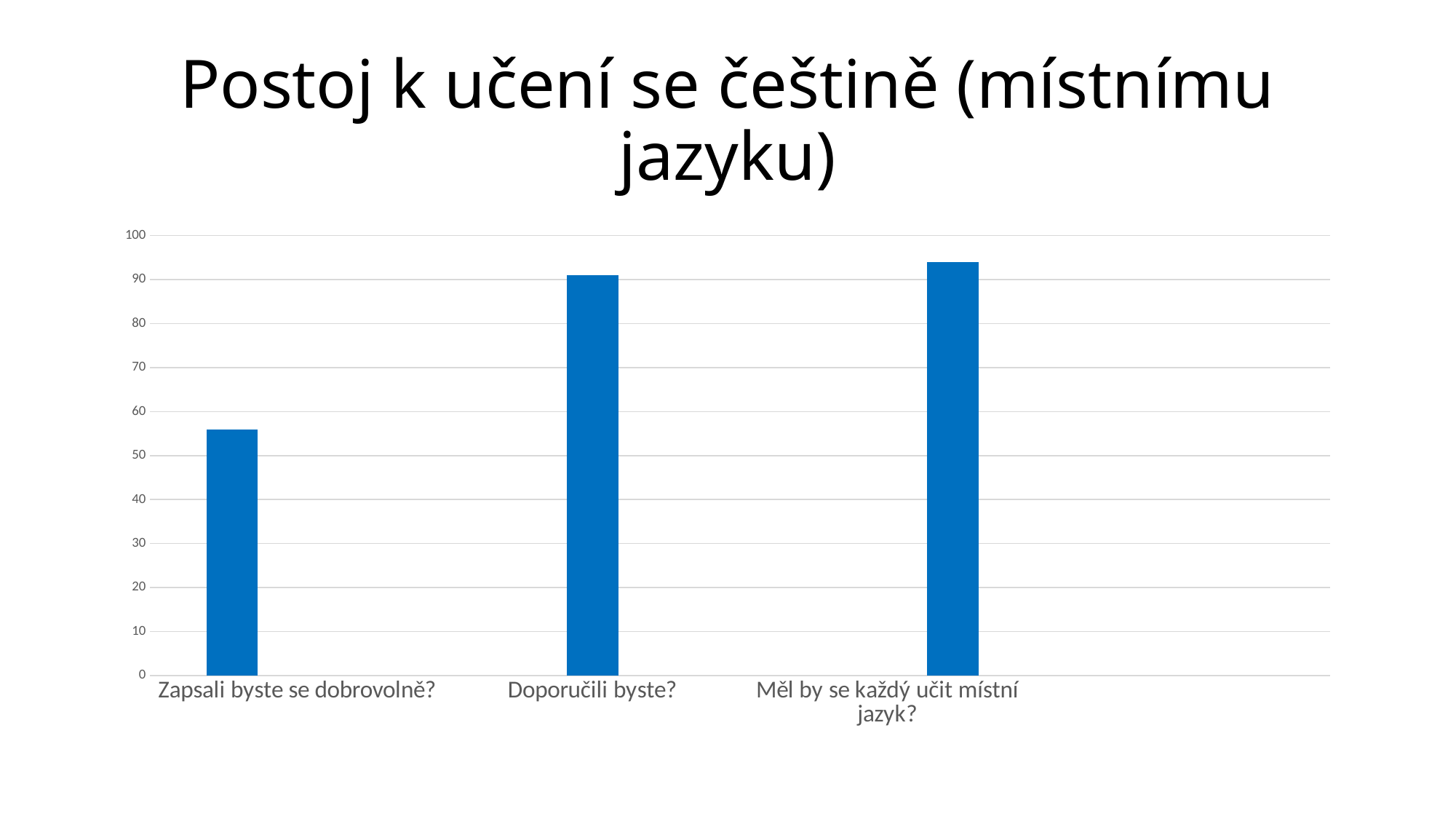
Is the value for "Zapsali byste se dobrovolně?" greater or less than 50? greater Which is larger: the value for "Zapsali byste se dobrovolně?" or the value for "Doporučili byste?"? Doporučili byste? How many categories are shown on the x axis of the chart? 3 Is the value for "Měl by se každý učit místní jazyk?" greater or less than 100? less Is the value for "Zapsali byste se dobrovolně?" greater or less than 60? less What is the title of the slide containing the chart? Postoj k učení se češtině (místnímu jazyku) What is the highest value shown on the vertical axis of the chart? 100 Which category has the highest bar in the chart? Měl by se každý učit místní jazyk? Do the bar values rise or fall from left to right along the x axis? rise Which category has the lowest bar in the chart? Zapsali byste se dobrovolně? What kind of chart is shown on the slide? bar chart